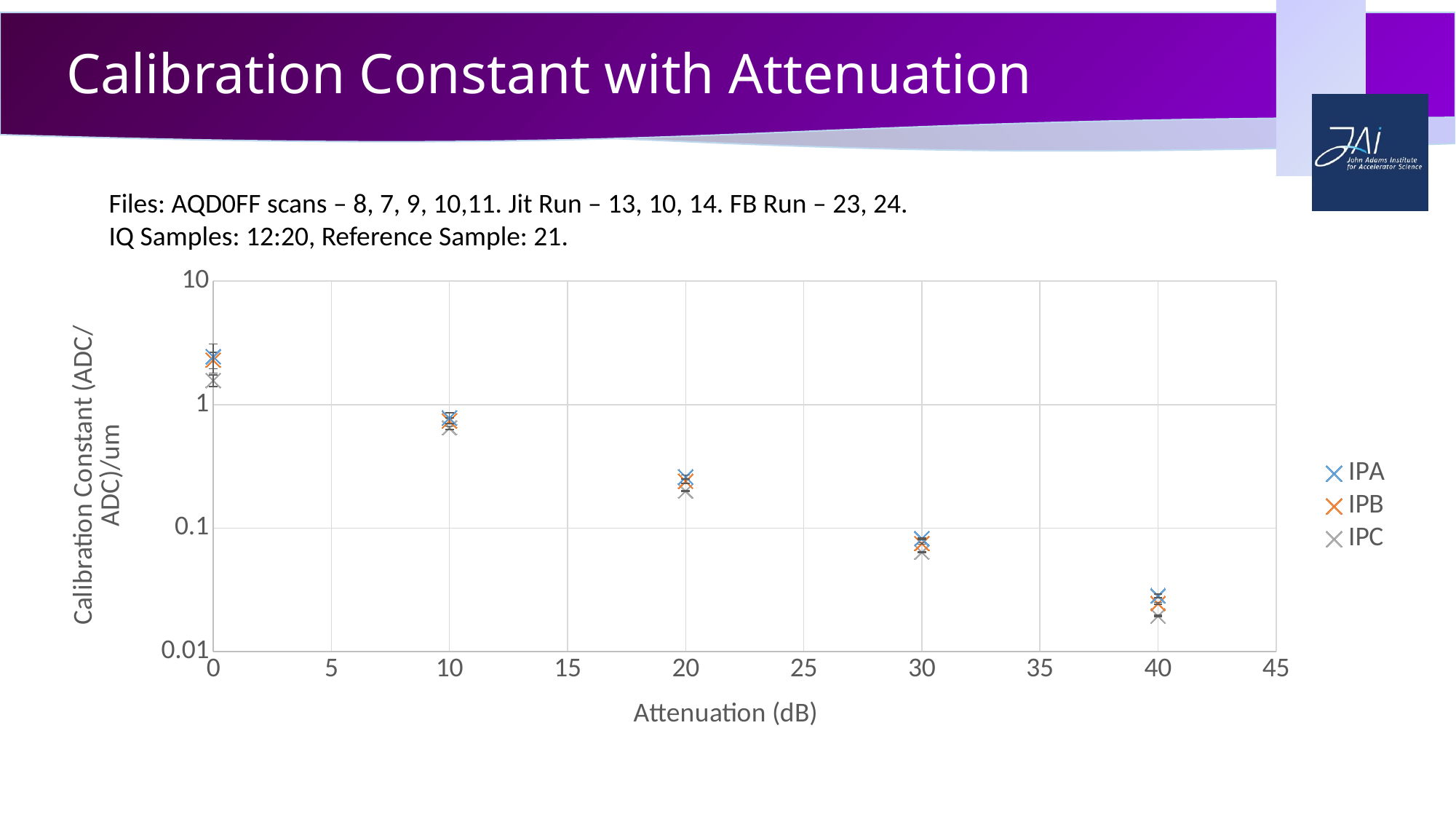
How many attenuation values are plotted for each series? 5 Is the value for IPB at 10 dB attenuation greater or less than 1? less Is the value for IPB at 40 dB attenuation greater or less than 0.1? less What kind of chart is shown on the slide? scatter chart Do the calibration constant values rise or fall as attenuation increases? fall Is the value for IPA at 20 dB attenuation greater or less than 0.1? greater What is the label of the x axis? Attenuation (dB) Which series has the lowest value at 0 dB attenuation? IPC Which series are listed in the legend? IPA, IPB, IPC How many series does the legend list? 3